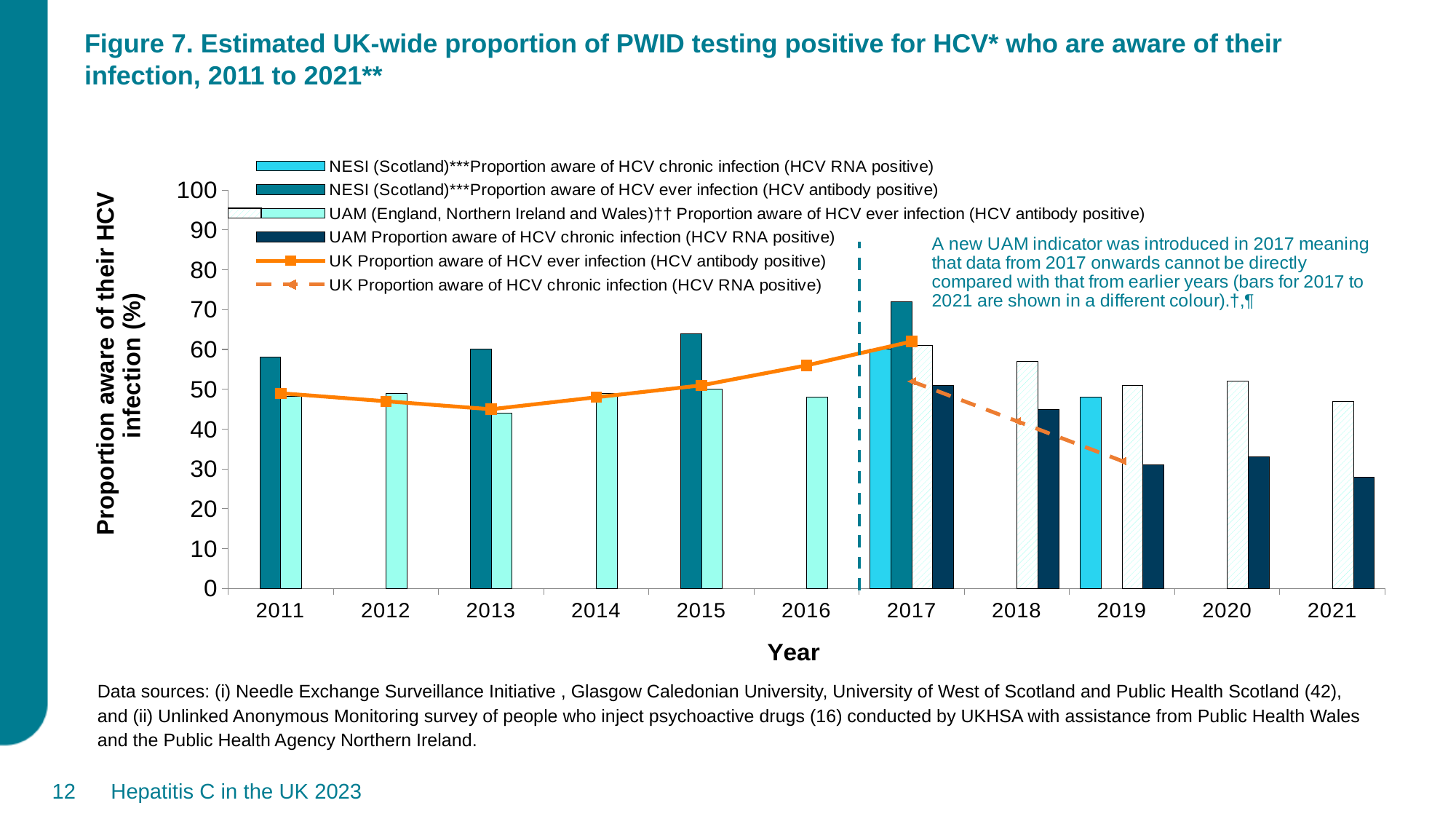
Is the NESI (Scotland) proportion aware of HCV ever infection in 2017 greater or less than 60? greater Is the UK proportion aware of HCV ever infection in 2013 greater or less than 50? less Is the NESI (Scotland) proportion aware of HCV ever infection in 2011 greater or less than 50? greater Does the UK proportion aware of HCV ever infection line rise or fall from 2013 to 2017? rise How many series does the chart's legend list? 6 In which year is the NESI (Scotland) proportion aware of HCV ever infection bar highest? 2017 Does the UK proportion aware of HCV chronic infection line rise or fall from 2017 to 2019? fall What kind of chart is this? Bar chart with line series How many years are shown on the x axis of the chart? 11 Which is larger: the UAM proportion aware of HCV chronic infection in 2017 or in 2021? 2017